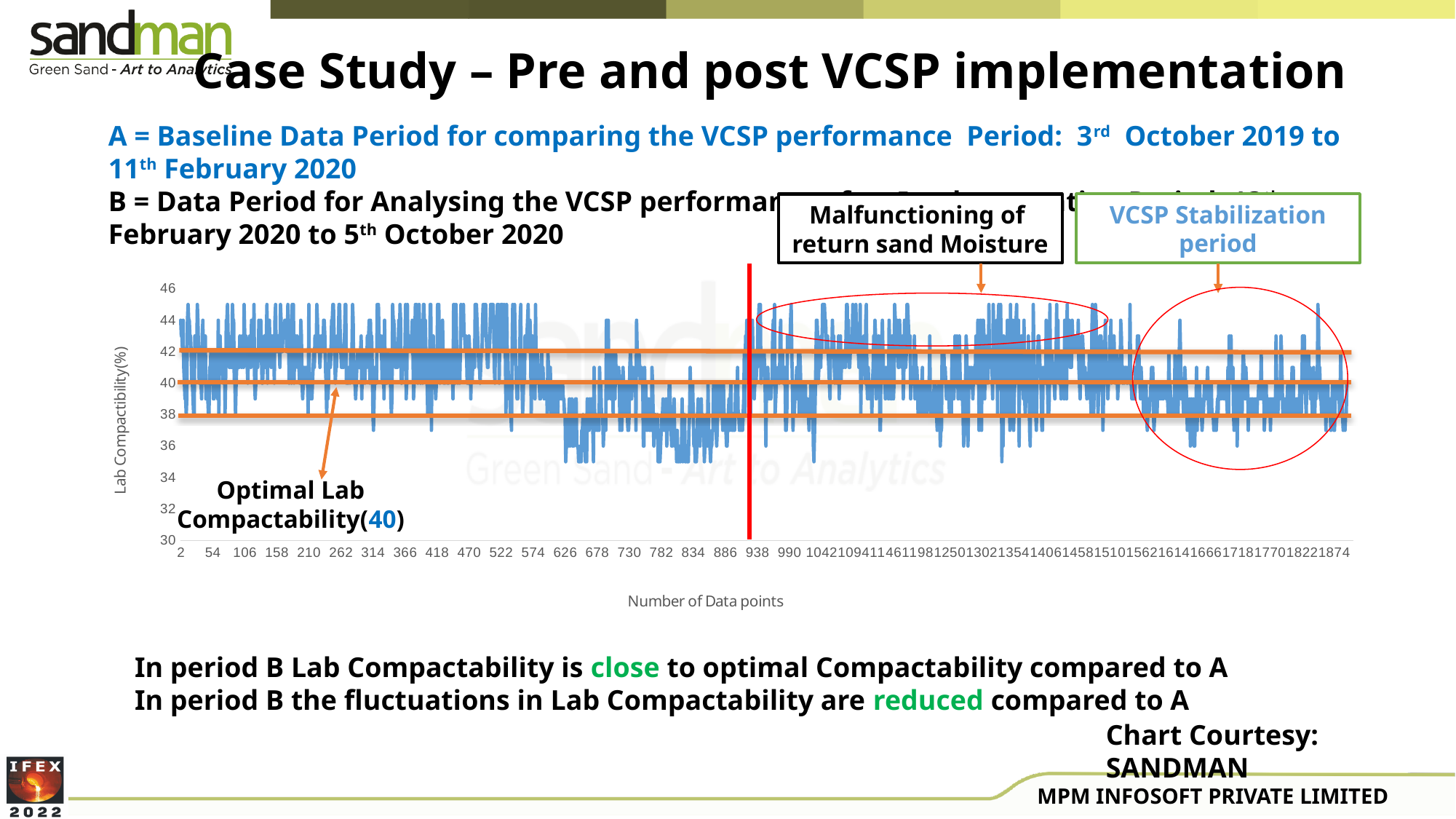
What is the highest value shown on the y axis of the chart? 46 What is the last tick value on the x axis of the chart? 1874 What kind of chart is shown on the slide? line chart What is the lowest value shown on the y axis of the chart? 30 What is the label of the y axis of the chart? Lab Compactibility(%) Is the Lab Compactability value at data point 2 greater or less than 40? greater What is the first tick value on the x axis of the chart? 2 What is the label of the x axis of the chart? Number of Data points At what y-axis values are the three orange horizontal reference lines drawn on the chart? 38, 40 and 42 How many data series are plotted in the chart? 1 What is the optimal Lab Compactability value marked on the chart? 40